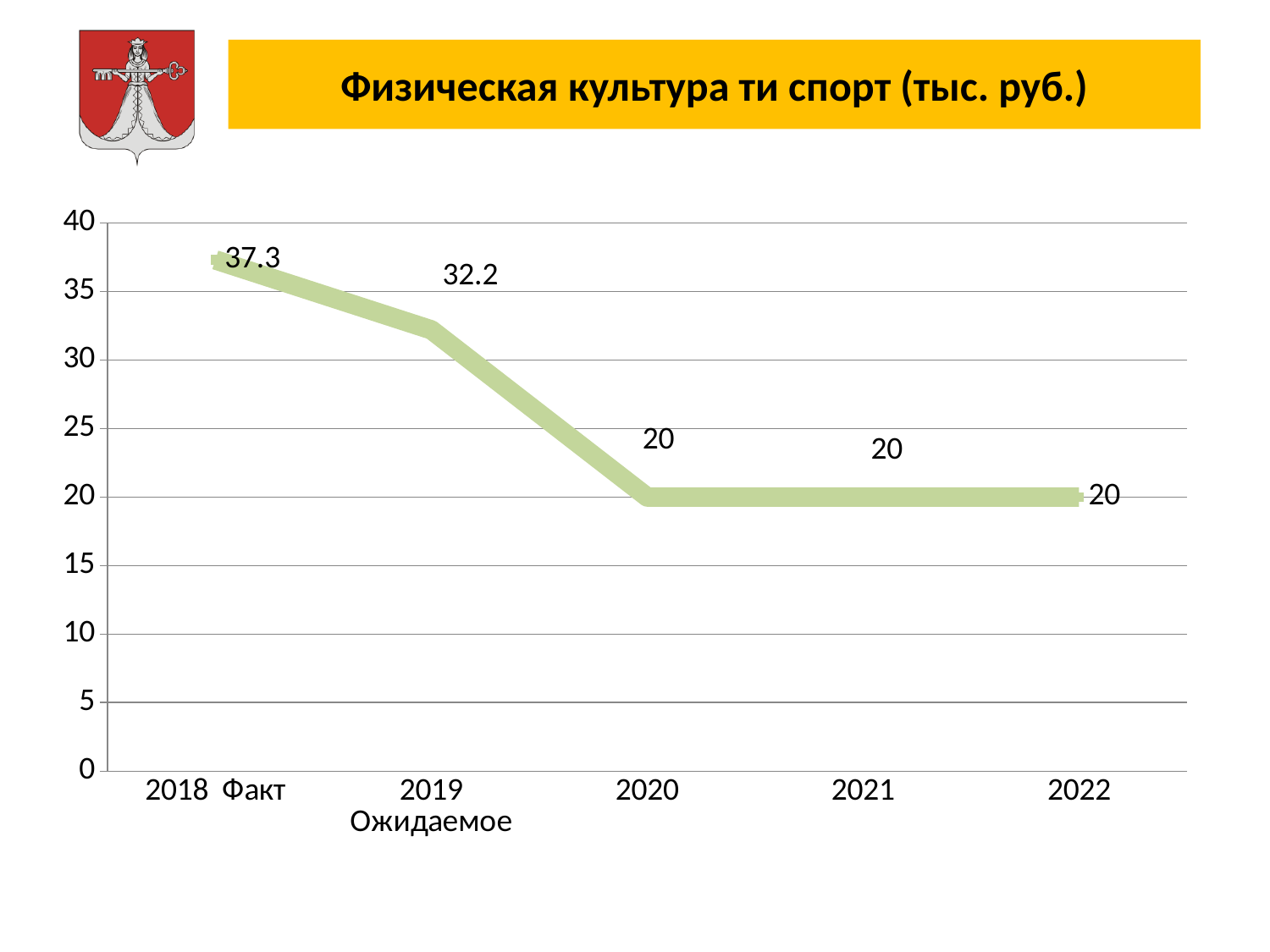
Is the value for 2019 Ожидаемое greater or less than 30? greater What is the value for 2018 Факт? 37.3 What kind of chart is shown on the slide? line chart What is the value for 2020? 20 What is the value for 2019 Ожидаемое? 32.2 What is the difference between the values for 2018 Факт and 2019 Ожидаемое? 5.1 What is the value for 2022? 20 What is the difference between the values for 2019 Ожидаемое and 2020? 12.2 Do the values rise or fall from 2018 to 2020? fall How many data points are plotted on the chart? 5 Which year has the highest value? 2018 Факт Which is larger, the value for 2018 Факт or the value for 2021? 2018 Факт